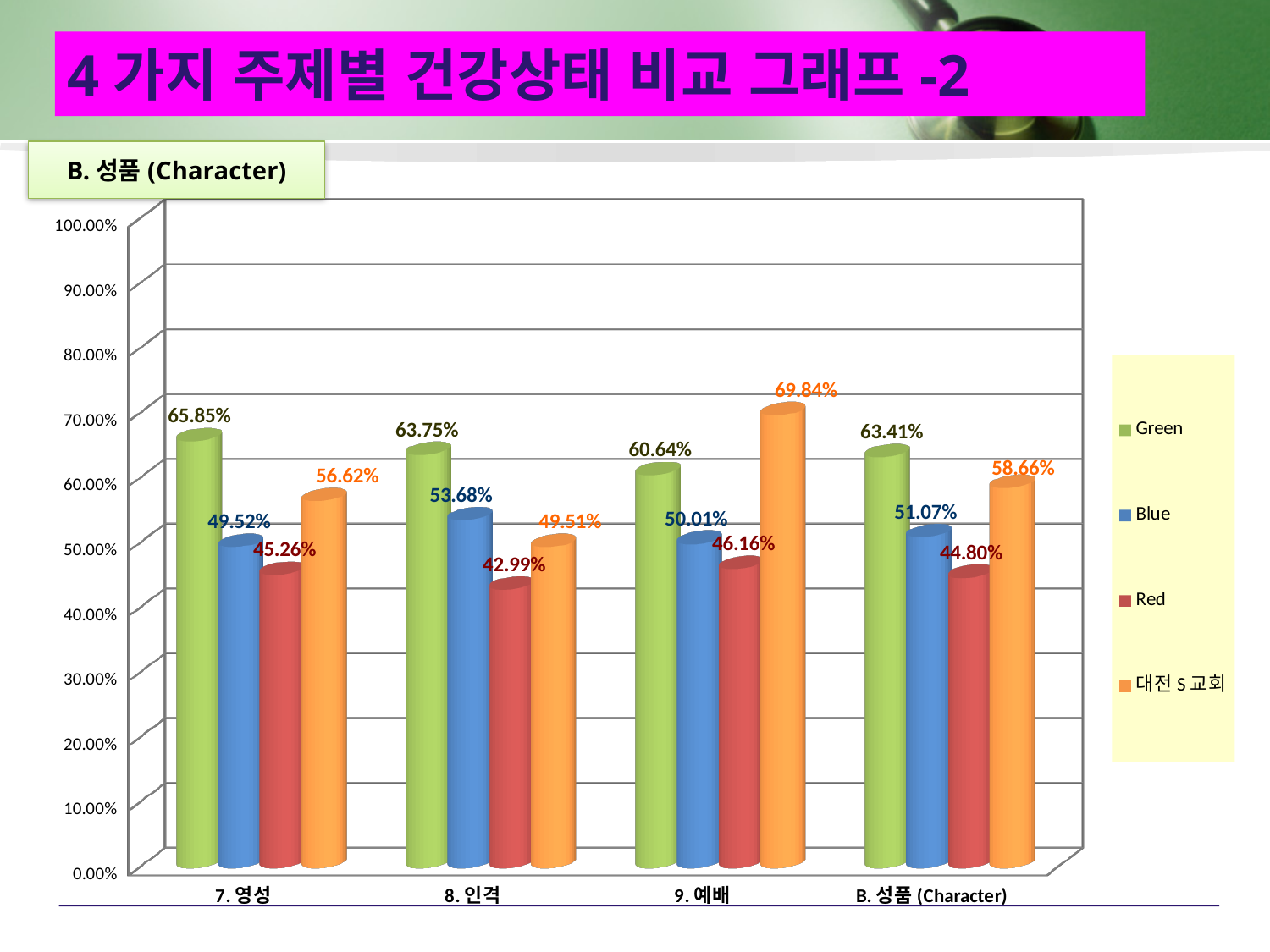
What kind of chart is shown on the slide? Bar chart In the 9. 예배 category, which is larger: the Green value or the 대전 S 교회 value? 대전 S 교회 What is the last entry listed in the legend? 대전 S 교회 What is the value for the Green series in the 7. 영성 category? 65.85% Which category has the lowest value for the Red series? 8. 인격 What is the difference between the Green and Red values in the 7. 영성 category? 20.59% What is the value for the 대전 S 교회 series in the 9. 예배 category? 69.84% How many categories are shown on the x axis? 4 Which category has the highest value for the 대전 S 교회 series? 9. 예배 What is the value for the Red series in the 8. 인격 category? 42.99% How many series does the legend list? 4 What is the value for the Blue series in the B. 성품 (Character) category? 51.07%